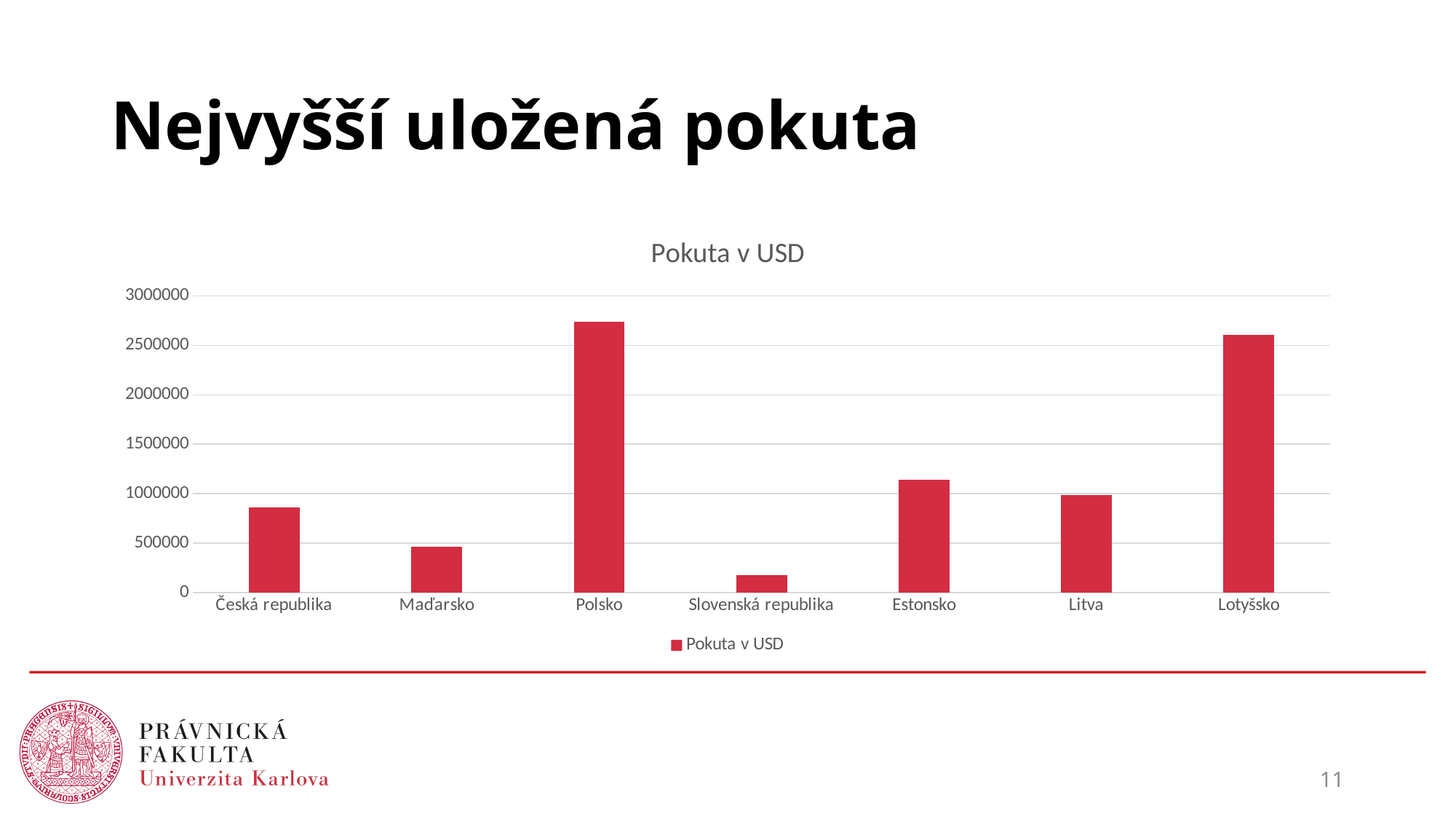
What type of chart is shown on the slide? Bar chart Is the value for Lotyšsko greater or less than 2000000? greater Is the value for Polsko greater or less than 2500000? greater Which country has the highest bar in the chart? Polsko Which country has the lowest bar in the chart? Slovenská republika How many series does the legend list? 1 Is the value for Česká republika greater or less than 1000000? less How many countries are shown on the x axis of the chart? 7 Which has the larger value, Estonsko or Litva? Estonsko Which has the larger value, Česká republika or Maďarsko? Česká republika